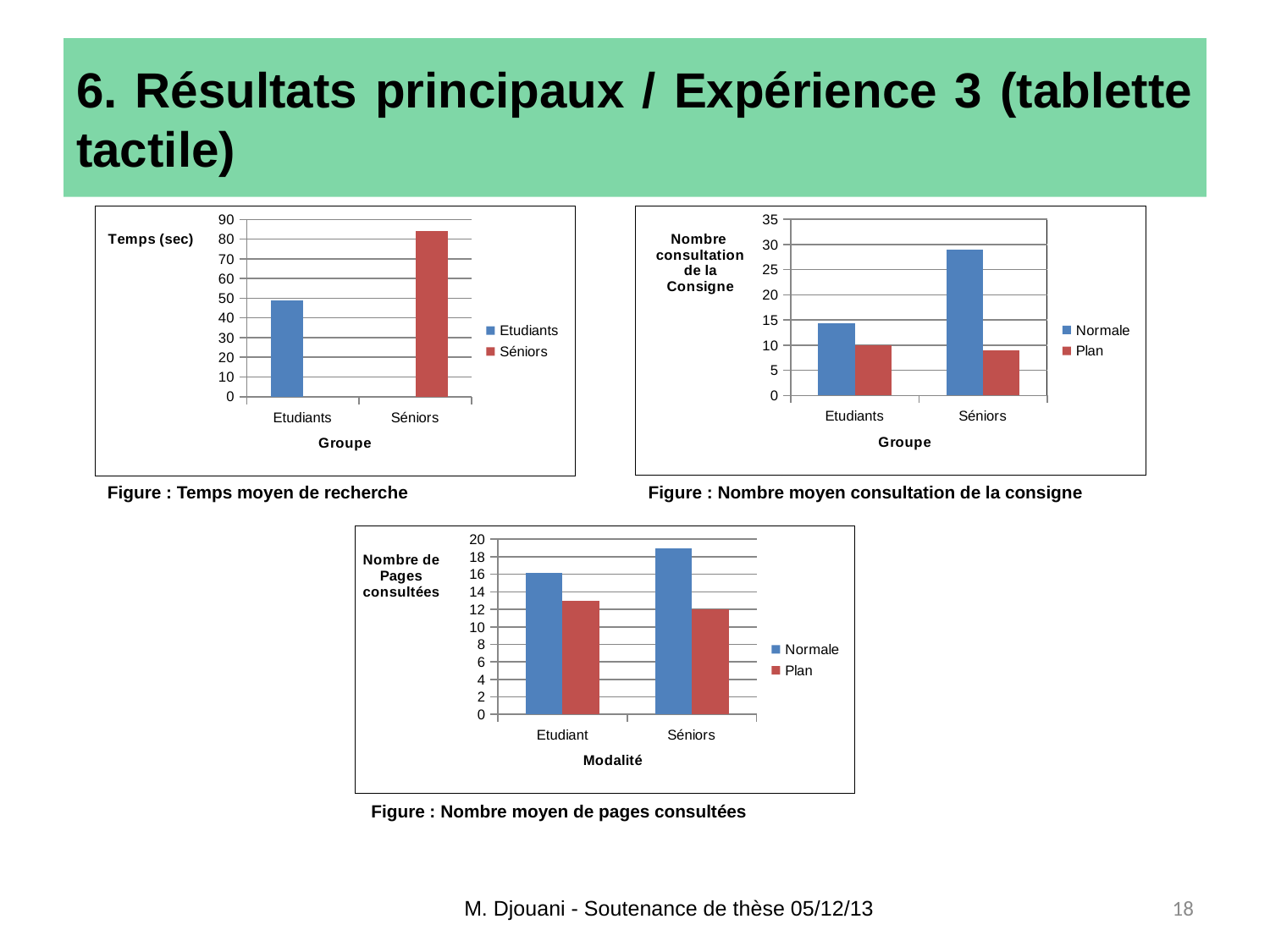
In the chart 'Nombre moyen de pages consultées', what is the label of the x axis? Modalité In the chart 'Nombre moyen consultation de la consigne', is the Plan value for Séniors greater or less than 10? less In the chart 'Nombre moyen consultation de la consigne', which is larger for Etudiants: Normale or Plan? Normale In the chart 'Temps moyen de recherche', is the value for Séniors greater or less than 80? greater In the chart 'Nombre moyen consultation de la consigne', is the Normale value for Séniors greater or less than 25? greater In the chart 'Temps moyen de recherche', which group has the higher value? Séniors In the chart 'Nombre moyen de pages consultées', which group has the higher Normale value? Séniors How many groups are shown on the x axis of the chart 'Nombre moyen de pages consultées'? 2 What kind of chart is 'Temps moyen de recherche'? bar chart In the chart 'Nombre moyen consultation de la consigne', how many series does the legend list? 2